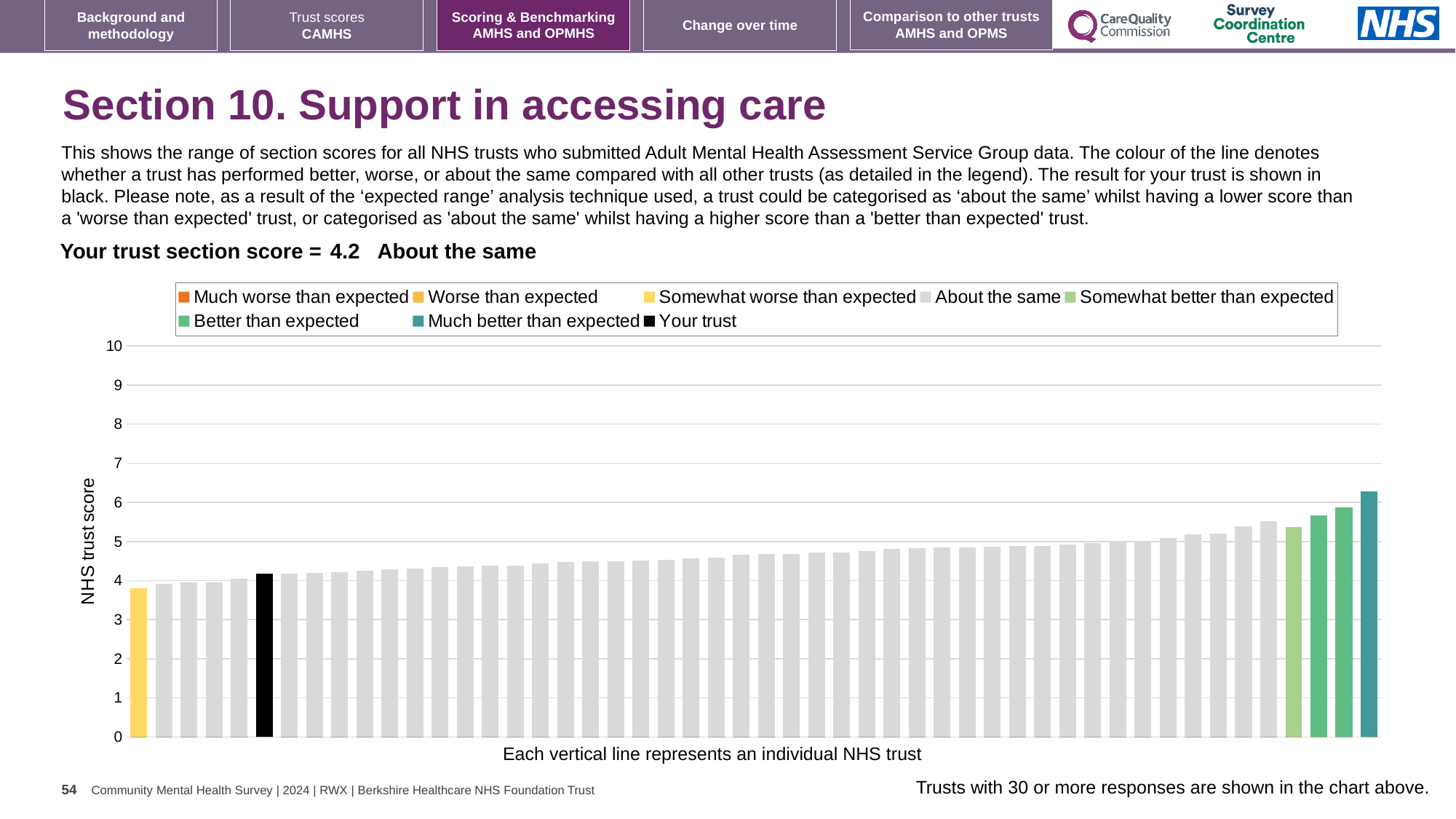
How many entries does the chart legend list? 8 Do the bar values rise or fall from left to right along the x axis? rise What is the section score for your trust shown on the slide? 4.2 What is the label on the y axis? NHS trust score What kind of chart is shown on the slide? bar chart How many bars are coloured as 'Better than expected'? 2 Is the value of the leftmost bar greater or less than 4? less Is the value for your trust greater or less than 5? less Which is larger, the value for your trust or the value of the leftmost bar? your trust Which legend category does the tallest bar belong to? Much better than expected What colour is the bar representing your trust? black Is the value of the tallest bar greater or less than 6? greater